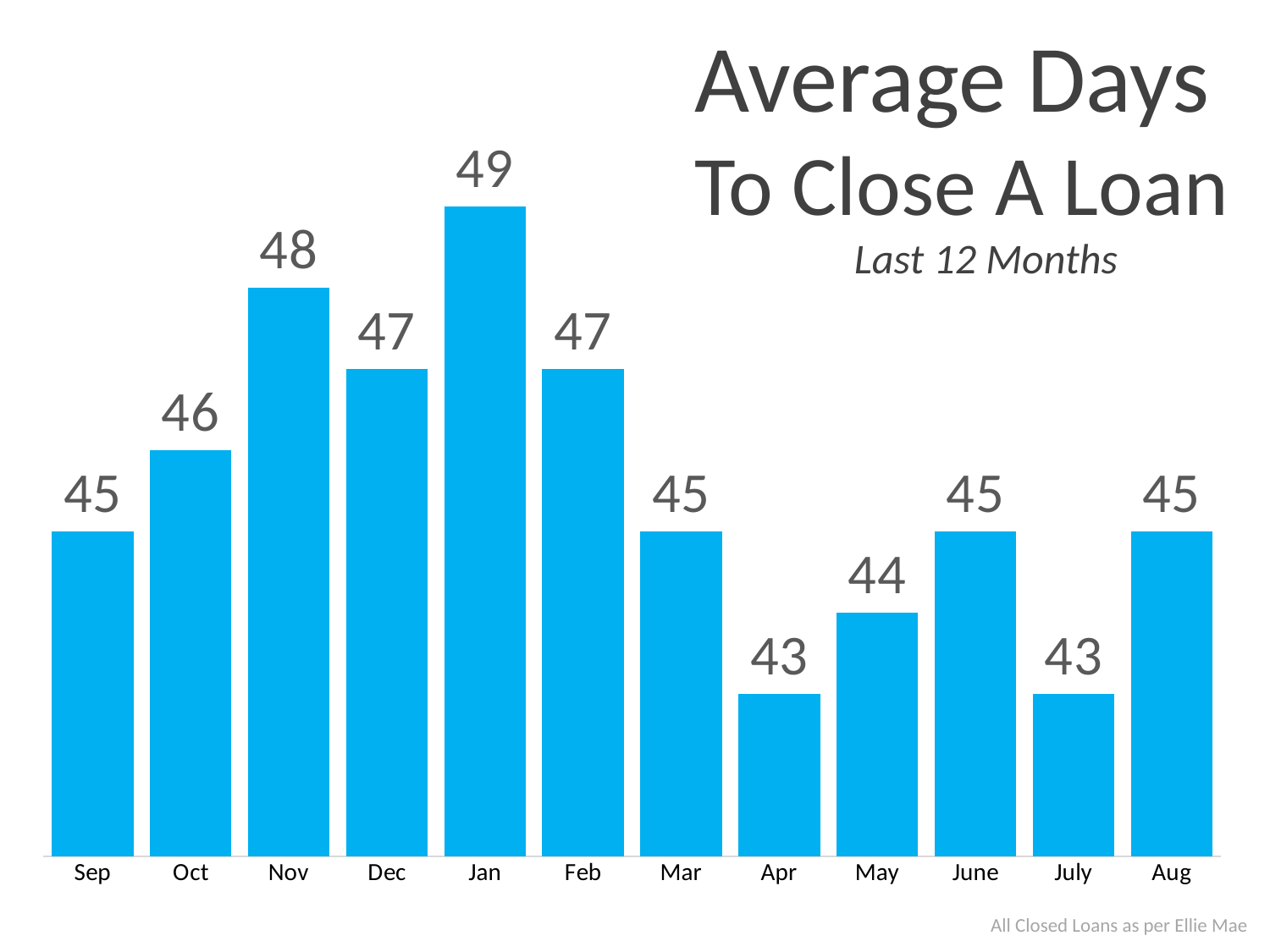
Which months have the lowest value on the chart? Apr and July Do the values rise or fall from Feb to Apr? Fall What is the value shown for May? 44 What is the difference between the values for Nov and Sep? 3 Which month has the highest average days to close a loan? Jan What kind of chart is shown on the slide? Bar chart What is the difference between the values for Jan and Apr? 6 What is the average days to close a loan in Jan? 49 How many months are shown on the chart? 12 What is the title of the chart? Average Days To Close A Loan Which is larger, the value for Dec or the value for Mar? Dec What is the value shown for Oct? 46